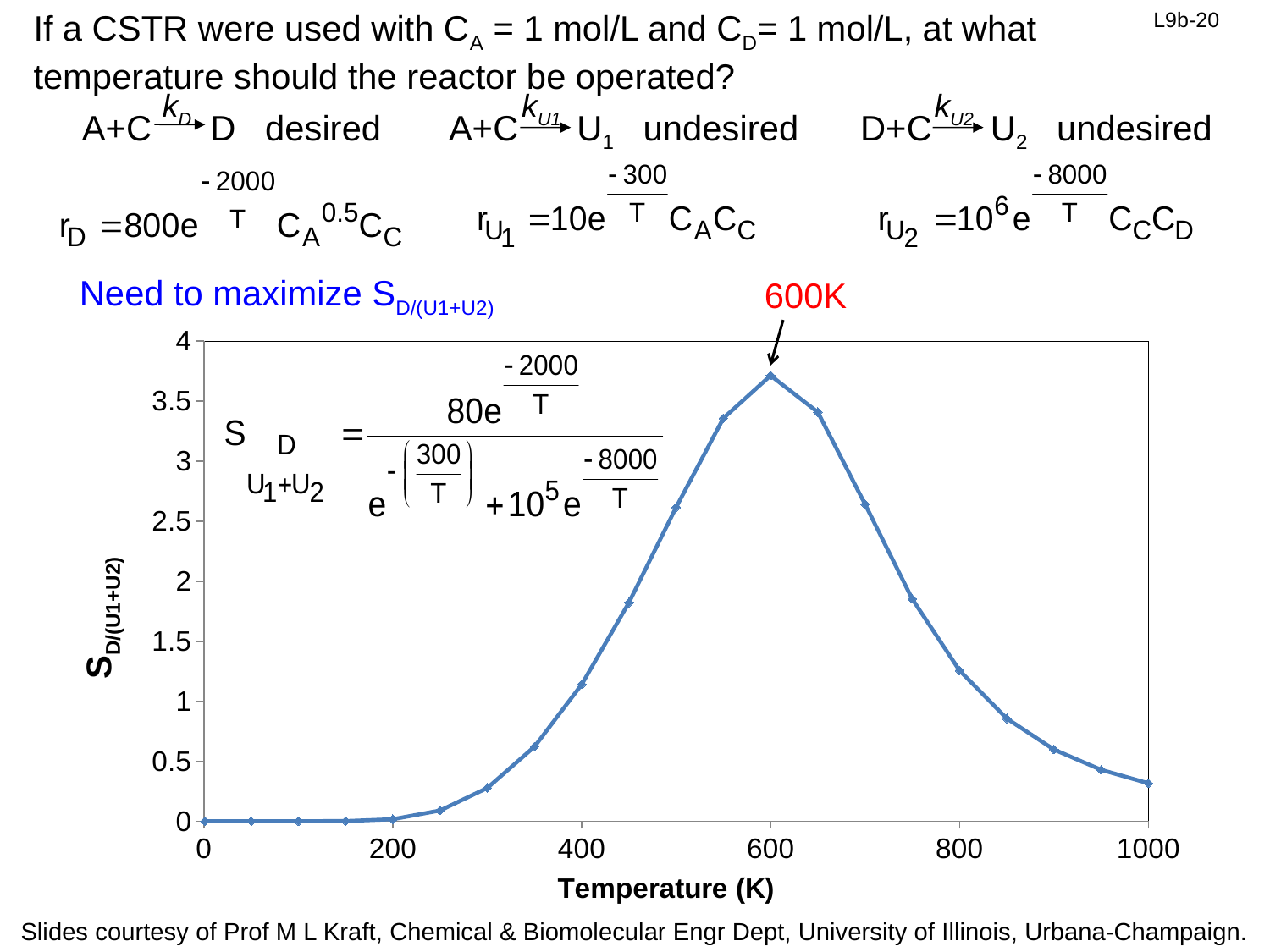
Which temperature has the larger selectivity value, 500 K or 800 K? 500 K What is the label of the y axis of the chart? S_D/(U1+U2) Does the selectivity rise or fall as temperature increases from 300 K to 600 K? rise What kind of chart is shown on the slide? line chart Is the selectivity value at 200 K greater or less than 0.5? less Is the selectivity value at 700 K greater or less than 2? greater At what temperature does the selectivity S_D/(U1+U2) reach its maximum? 600K What is the label of the x axis of the chart? Temperature (K) Is the selectivity value at 600 K greater or less than 3.5? greater Does the selectivity rise or fall as temperature increases from 600 K to 1000 K? fall